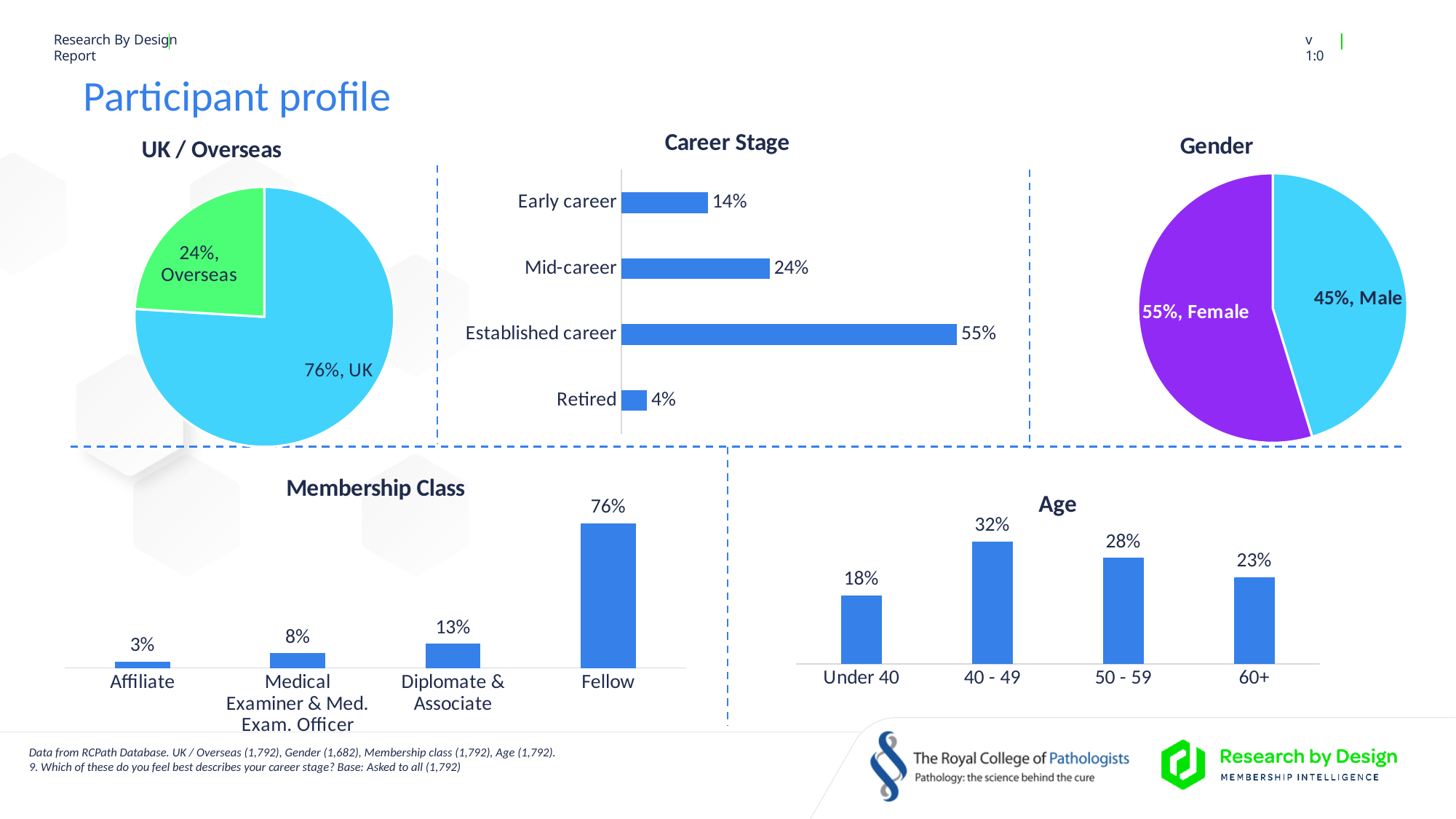
In the Age chart, which age group has the highest value? 40 - 49 In the Gender chart, what percentage of participants are Female? 55% In the Career Stage chart, what is the value for Established career? 55% In the Gender chart, which is larger, Male or Female? Female In the Membership Class chart, what is the value for Diplomate & Associate? 13% In the Career Stage chart, what is the difference between Mid-career and Early career? 10% What kind of chart is the Career Stage chart? Bar chart How many categories are shown in the Membership Class chart? 4 In the Age chart, what is the difference between the 50 - 59 and 60+ groups? 5% In the UK / Overseas chart, what share of participants are from the UK? 76% In the Membership Class chart, which category has the highest value? Fellow In the Career Stage chart, which career stage has the lowest value? Retired